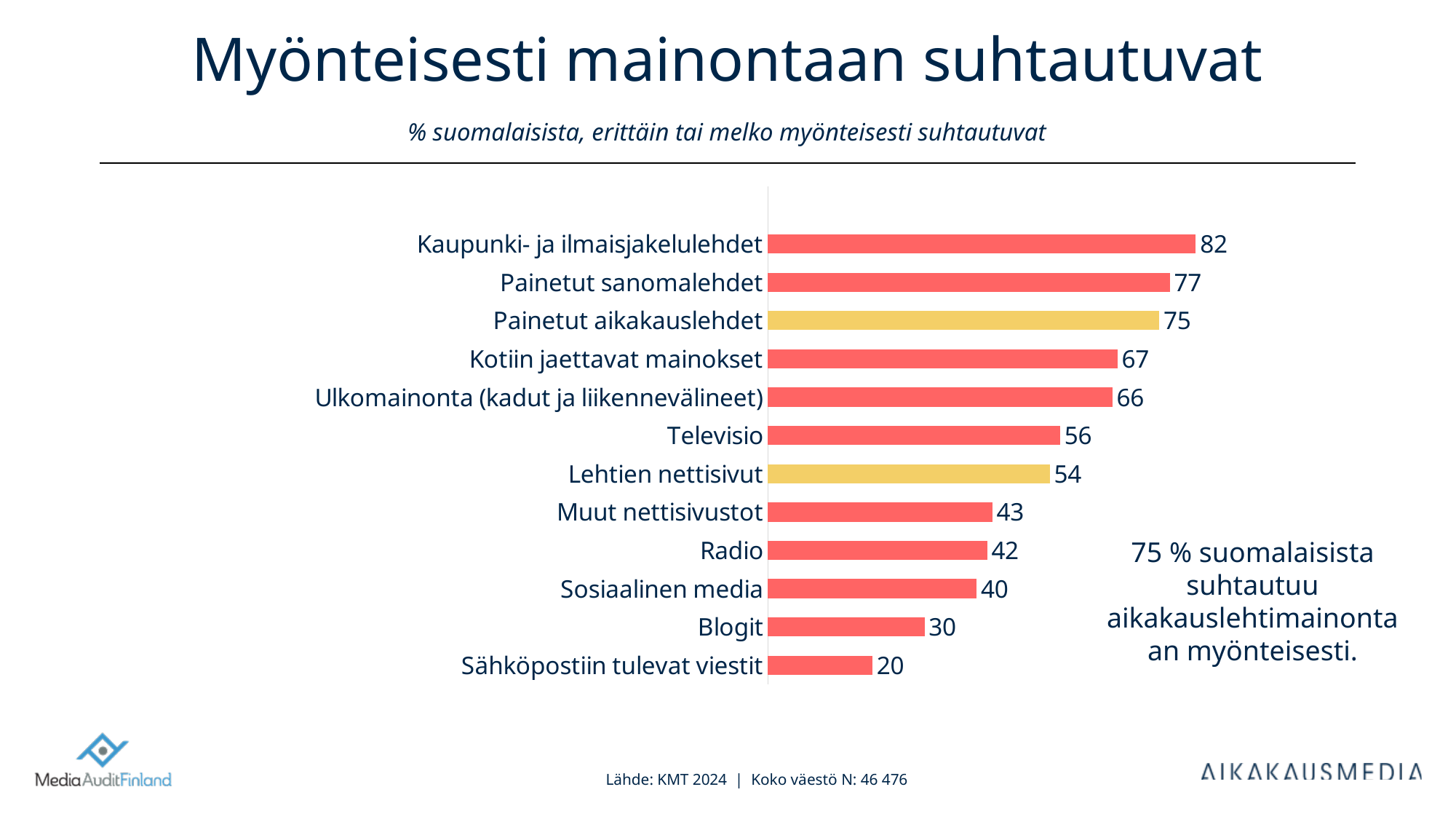
Which two categories are shown with yellow bars instead of red? Painetut aikakauslehdet and Lehtien nettisivut Which category has the highest value? Kaupunki- ja ilmaisjakelulehdet What is the difference between the values for Kaupunki- ja ilmaisjakelulehdet and Painetut sanomalehdet? 5 What is the value for Painetut aikakauslehdet? 75 What is the value for Sosiaalinen media? 40 What is the value for Televisio? 56 Which is larger, the value for Radio or the value for Blogit? Radio Which is larger, the value for Kotiin jaettavat mainokset or the value for Televisio? Kotiin jaettavat mainokset What kind of chart is shown on the slide? Bar chart How many categories are shown in the chart? 12 What is the difference between the values for Lehtien nettisivut and Blogit? 24 Which category has the lowest value? Sähköpostiin tulevat viestit